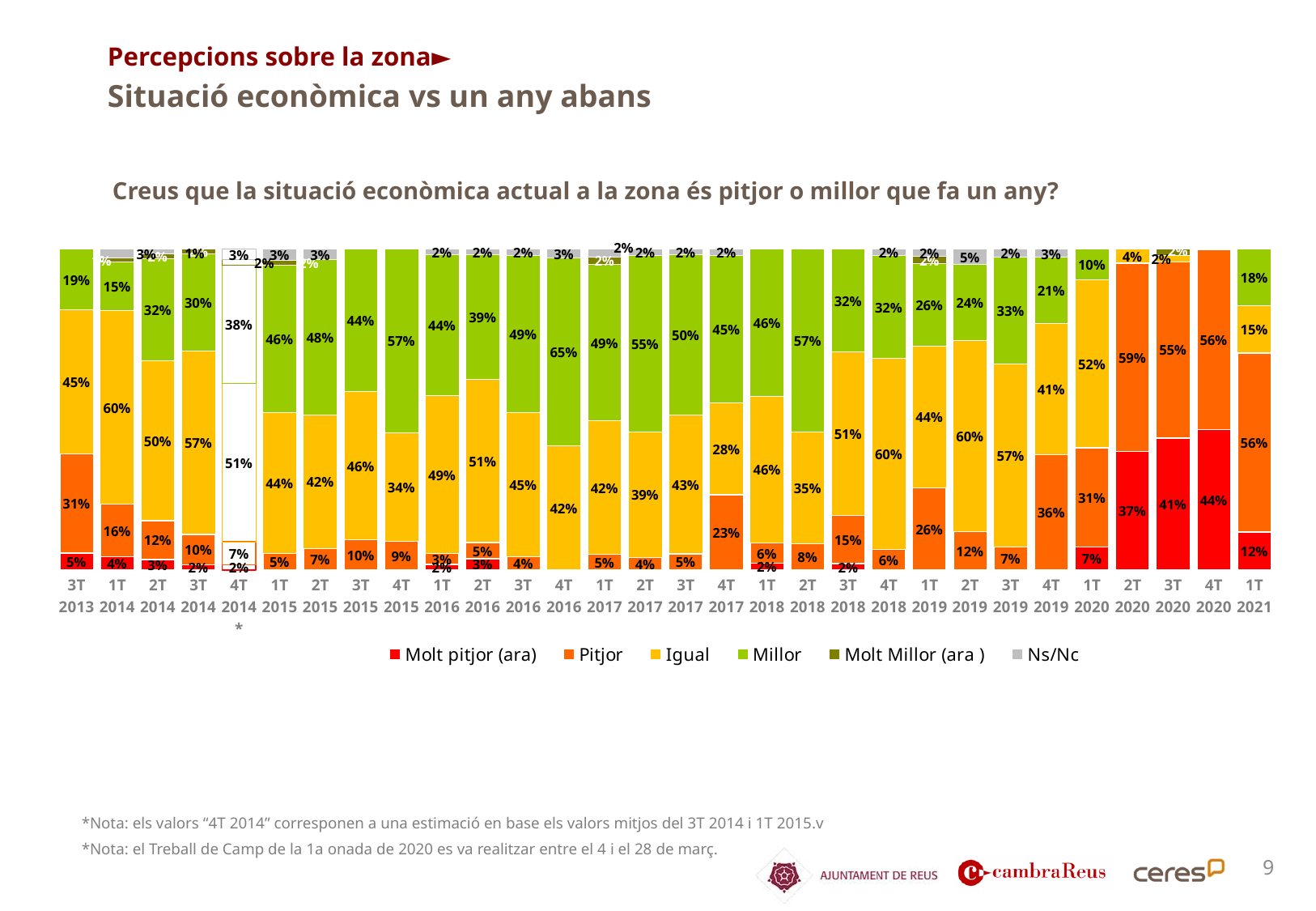
In which quarter is the 'Molt pitjor (ara)' value highest? 4T 2020 Which series is listed first in the legend? Molt pitjor (ara) What is the value for 'Igual' in 1T 2014? 60% How many series does the legend list? 6 In 1T 2021, which is larger: 'Millor' or 'Igual'? Millor Does the 'Molt pitjor (ara)' value rise or fall from 1T 2020 to 4T 2020? Rises What is the value for 'Pitjor' in 4T 2017? 23% What is the value for 'Millor' in 4T 2015? 57% What is the difference between the 'Pitjor' value in 2T 2020 and in 1T 2020? 28 percentage points What is the value for 'Molt pitjor (ara)' in 4T 2020? 44% What kind of chart is shown on the slide? Stacked bar chart What is the value for 'Millor' in 1T 2020? 10%